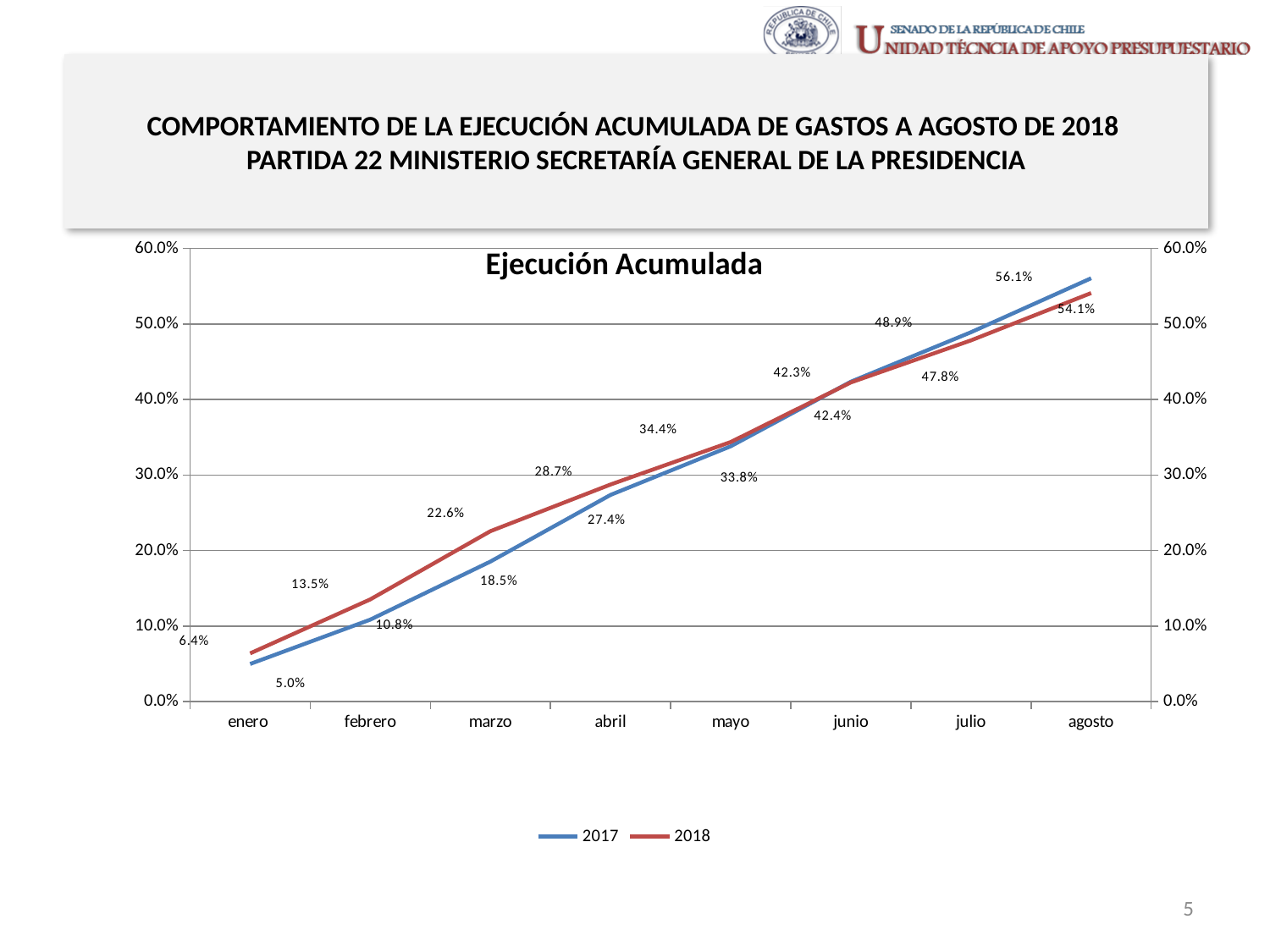
What is the value for 2017 in mayo? 33.8% In febrero, which series has the higher value, 2017 or 2018? 2018 What is the difference between the 2018 and 2017 values in marzo? 4.1 percentage points Is the value for 2017 in agosto greater or less than 50.0%? greater What is the value for 2018 in enero? 6.4% What is the value for 2017 in marzo? 18.5% What is the value for 2018 in abril? 28.7% What is the title of the chart? Ejecución Acumulada Do the values for 2017 rise or fall from enero to agosto? Rise How many months are plotted along the x axis? 8 What kind of chart is shown on the slide? Line chart How many series does the legend list? 2